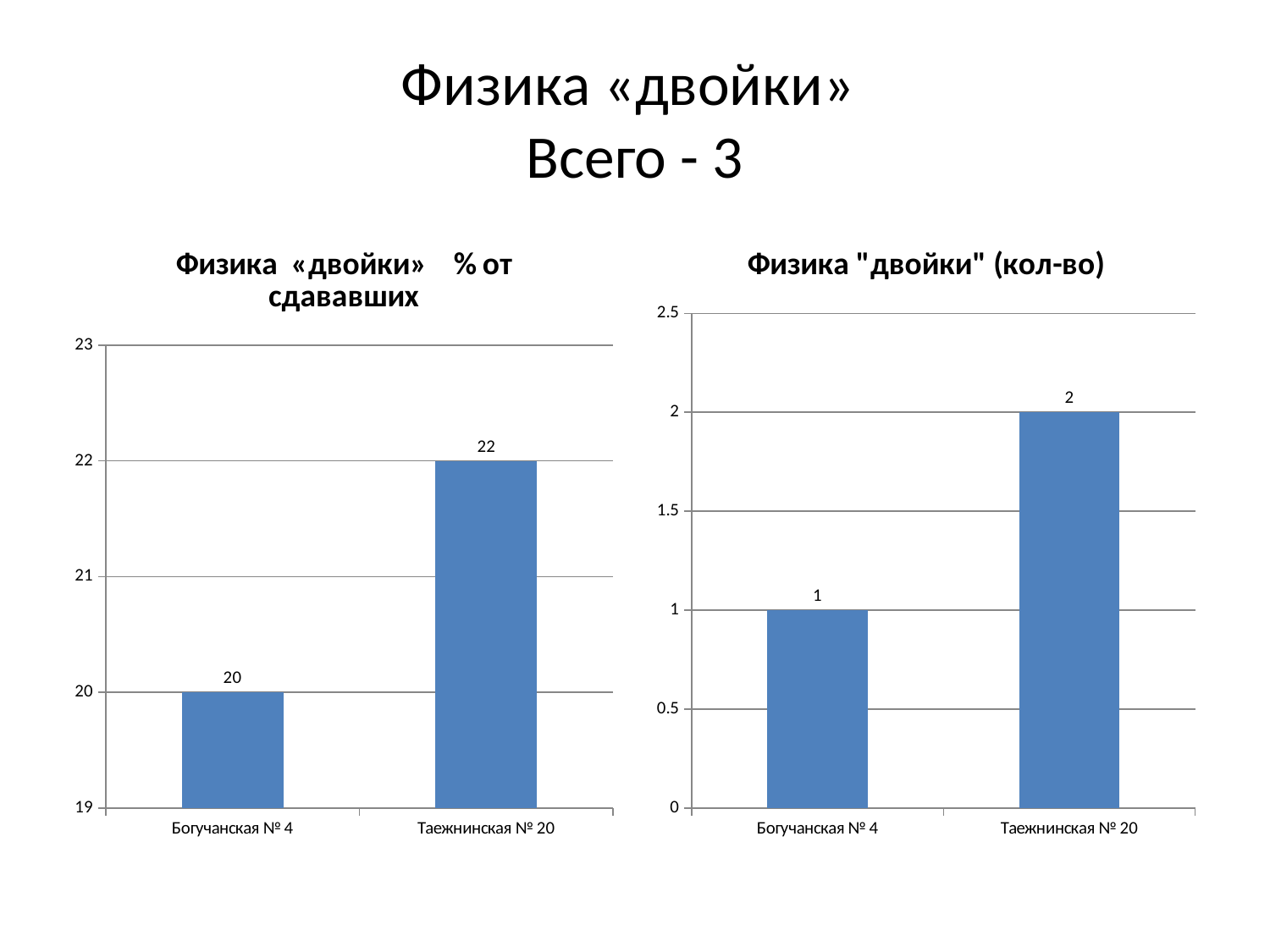
What type of chart is the right chart (Физика "двойки" (кол-во))? bar chart How many categories are shown in the left chart (Физика «двойки» % от сдававших)? 2 In the right chart (Физика "двойки" (кол-во)), which is larger: the value for Богучанская № 4 or Таежнинская № 20? Таежнинская № 20 In the right chart (Физика "двойки" (кол-во)), which category has the lowest value? Богучанская № 4 In the left chart (Физика «двойки» % от сдававших), what is the value for Богучанская № 4? 20 In the left chart (Физика «двойки» % от сдававших), which category has the highest value? Таежнинская № 20 In the left chart (Физика «двойки» % от сдававших), what is the difference between the values for Таежнинская № 20 and Богучанская № 4? 2 In the left chart (Физика «двойки» % от сдававших), what is the value for Таежнинская № 20? 22 In the right chart (Физика "двойки" (кол-во)), what is the value for Богучанская № 4? 1 In the right chart (Физика "двойки" (кол-во)), what is the value for Таежнинская № 20? 2 What is the title of the right chart? Физика "двойки" (кол-во) In the right chart (Физика "двойки" (кол-во)), what is the difference between the values for Таежнинская № 20 and Богучанская № 4? 1